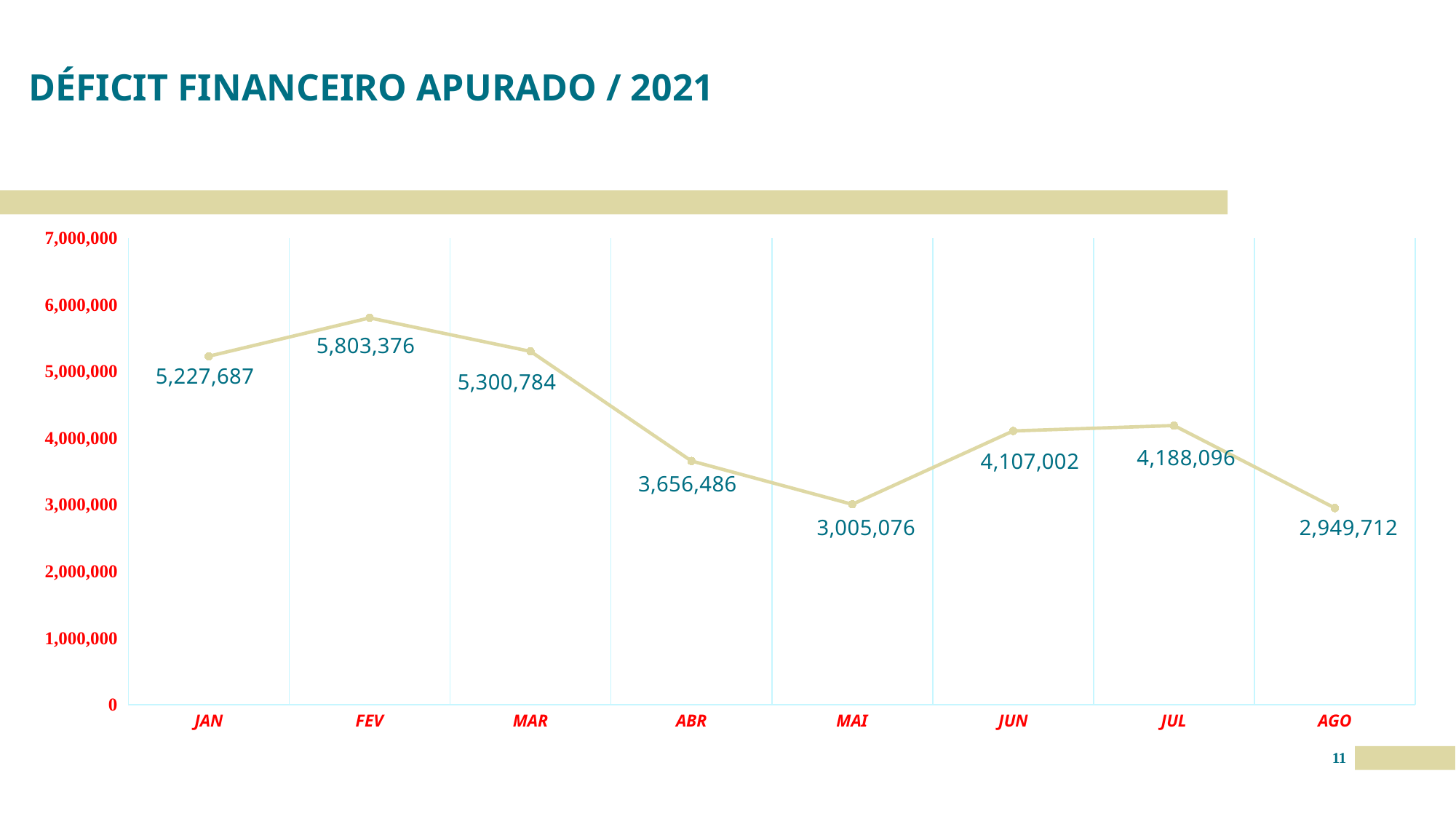
How many months are plotted on the chart? 8 What is the value for MAI? 3,005,076 What is the difference between the values for MAR and ABR? 1,644,298 What is the difference between the values for FEV and JAN? 575,689 What kind of chart is shown on the slide? line chart Do the values rise or fall from MAR to MAI? fall What is the value for FEV? 5,803,376 Which is larger, the value for JUN or the value for JUL? JUL Is the value for ABR greater or less than 4,000,000? less Which month has the highest value? FEV What is the value for AGO? 2,949,712 Which month has the lowest value? AGO